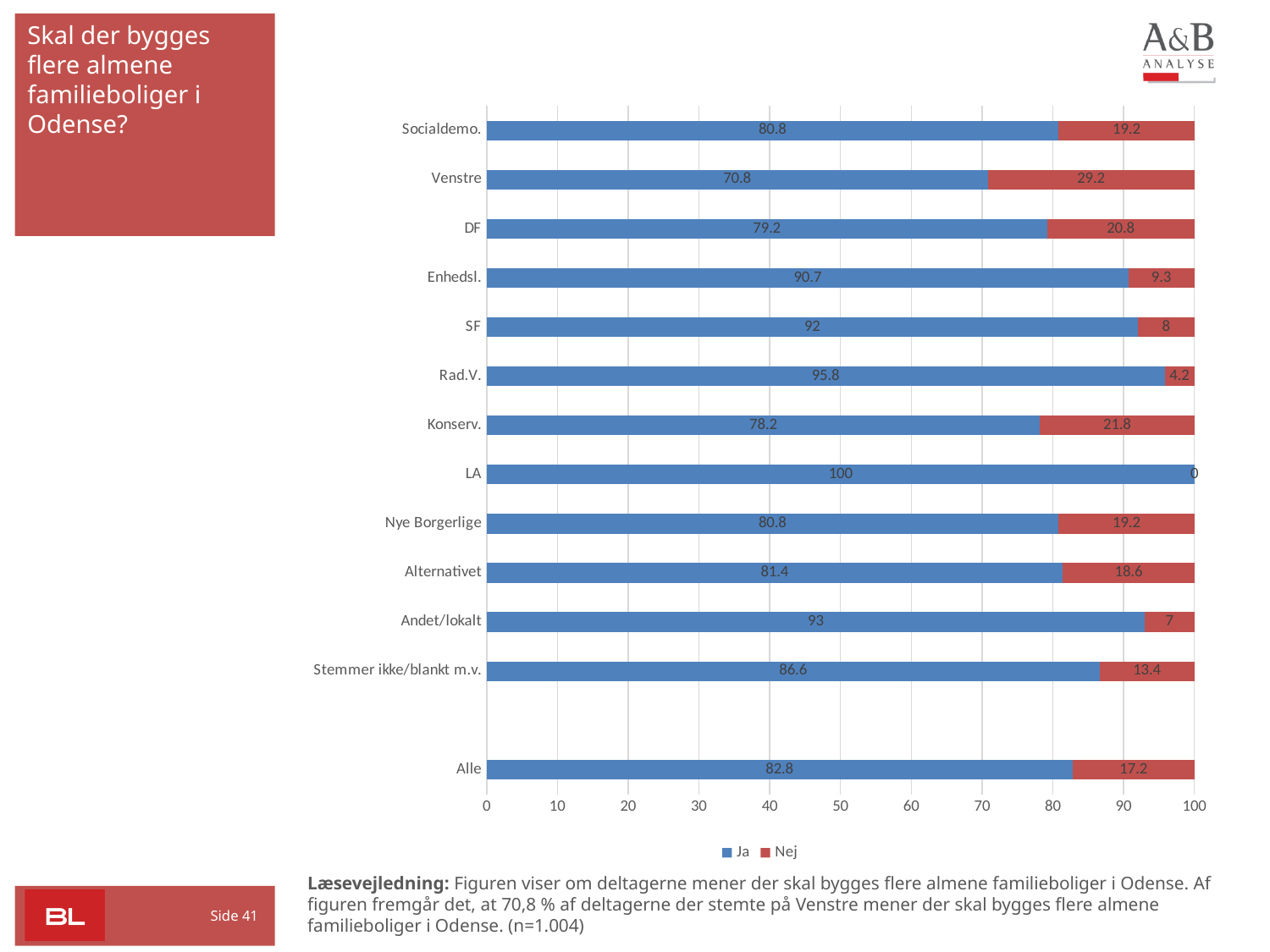
Which has a larger Nej value, Enhedsl. or Stemmer ikke/blankt m.v.? Stemmer ikke/blankt m.v. Which category has the highest Ja value? LA What kind of chart is shown on the slide? Stacked bar chart How many series does the legend list? 2 What is the Nej value for Konserv.? 21.8 What is the total of the stacked bar for Rad.V.? 100 Which category has the lowest Ja value? Venstre What is the Ja value for Venstre? 70.8 What is the Ja value for Alle? 82.8 Which category has the highest Nej value? Venstre What is the difference between the Ja values for SF and DF? 12.8 How many categories are shown on the chart? 13